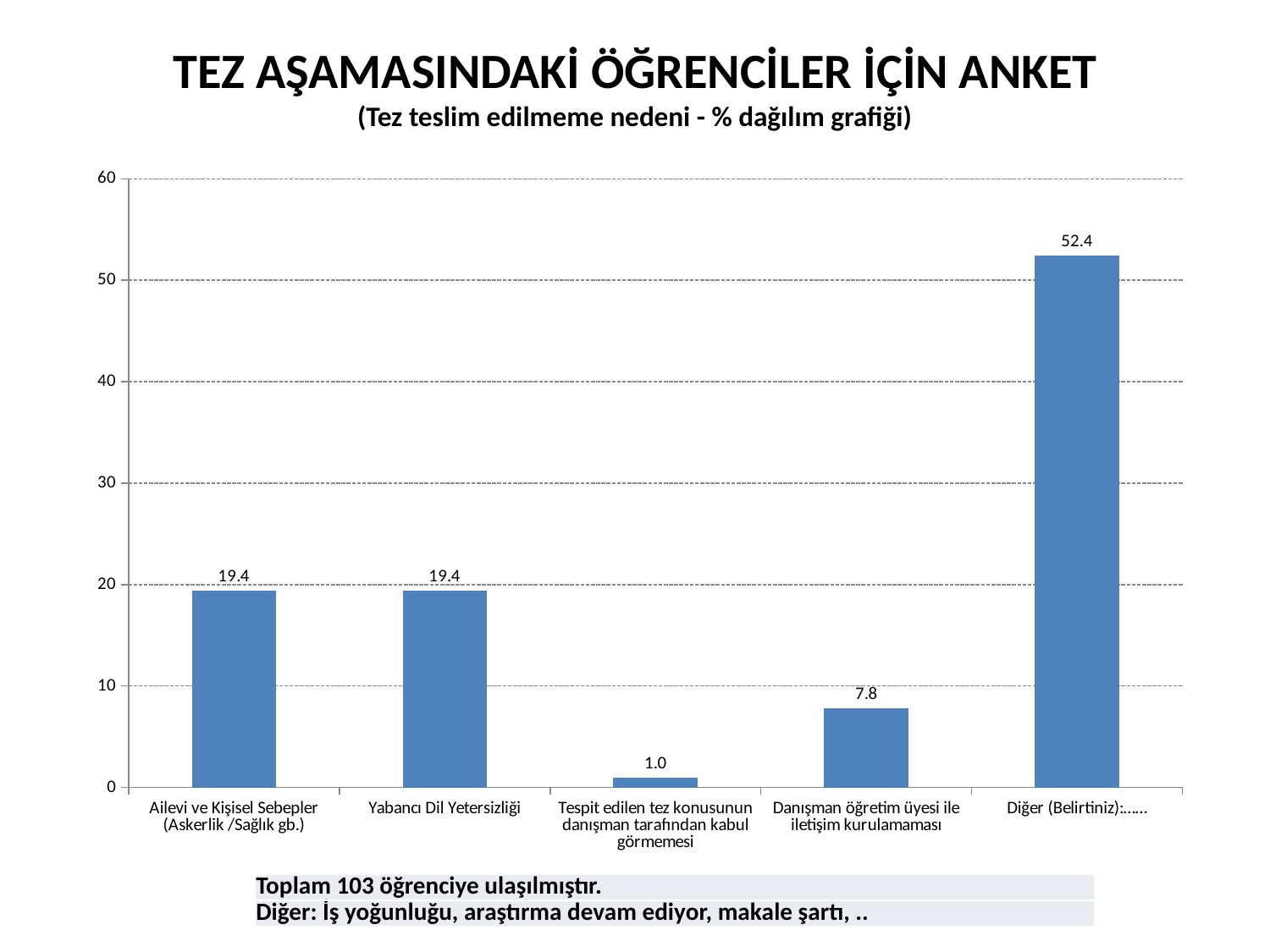
What is the difference between the values for "Diğer (Belirtiniz):……" and "Ailevi ve Kişisel Sebepler (Askerlik /Sağlık gb.)"? 33.0 What is the value for "Danışman öğretim üyesi ile iletişim kurulamaması"? 7.8 What is the maximum value shown on the y axis? 60 How many categories are shown on the x axis? 5 What kind of chart is shown on the slide? bar chart Which category has the highest value? Diğer (Belirtiniz):…… Which is larger: the value for "Danışman öğretim üyesi ile iletişim kurulamaması" or the value for "Tespit edilen tez konusunun danışman tarafından kabul görmemesi"? Danışman öğretim üyesi ile iletişim kurulamaması What is the value for "Diğer (Belirtiniz):……"? 52.4 What is the value for "Yabancı Dil Yetersizliği"? 19.4 Is the value for "Diğer (Belirtiniz):……" greater or less than 50? greater Which category has the lowest value? Tespit edilen tez konusunun danışman tarafından kabul görmemesi What is the subtitle shown under the main title of the slide? (Tez teslim edilmeme nedeni - % dağılım grafiği)